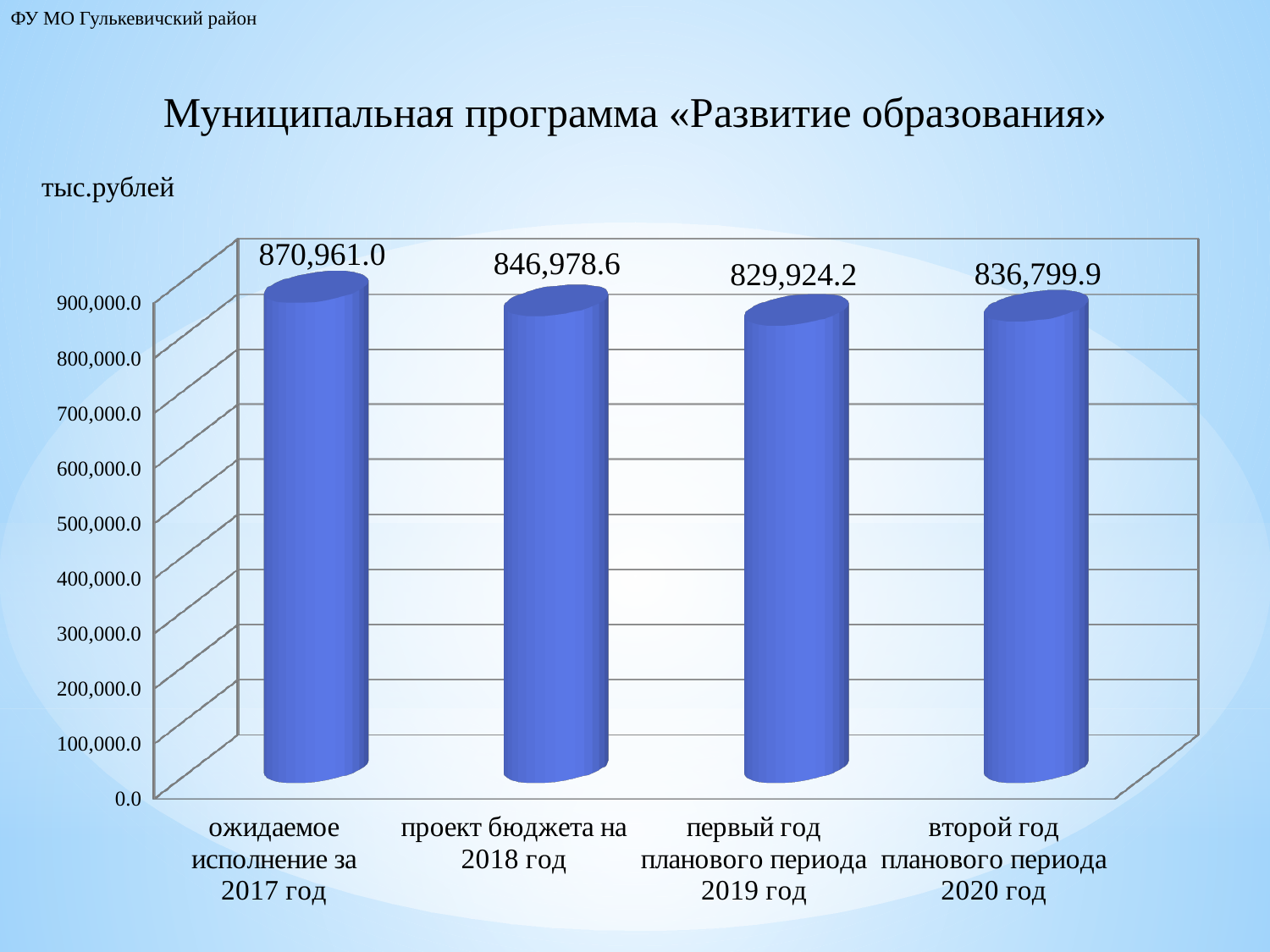
Which is larger: the value for 2018 or the value for 2020? 2018 (846,978.6) How many categories are shown in the chart? 4 Which category has the lowest value? первый год планового периода 2019 год Which category has the highest value? ожидаемое исполнение за 2017 год What is the value for 'проект бюджета на 2018 год'? 846,978.6 What is the difference between the value for 2020 and the value for 2019? 6,875.7 What is the value for 'первый год планового периода 2019 год'? 829,924.2 What kind of chart is shown on the slide? bar chart What is the value for 'ожидаемое исполнение за 2017 год'? 870,961.0 Is the value for 2019 greater or less than 800,000.0? greater What is the value for 'второй год планового периода 2020 год'? 836,799.9 What is the difference between the value for 2017 and the value for 2018? 23,982.4